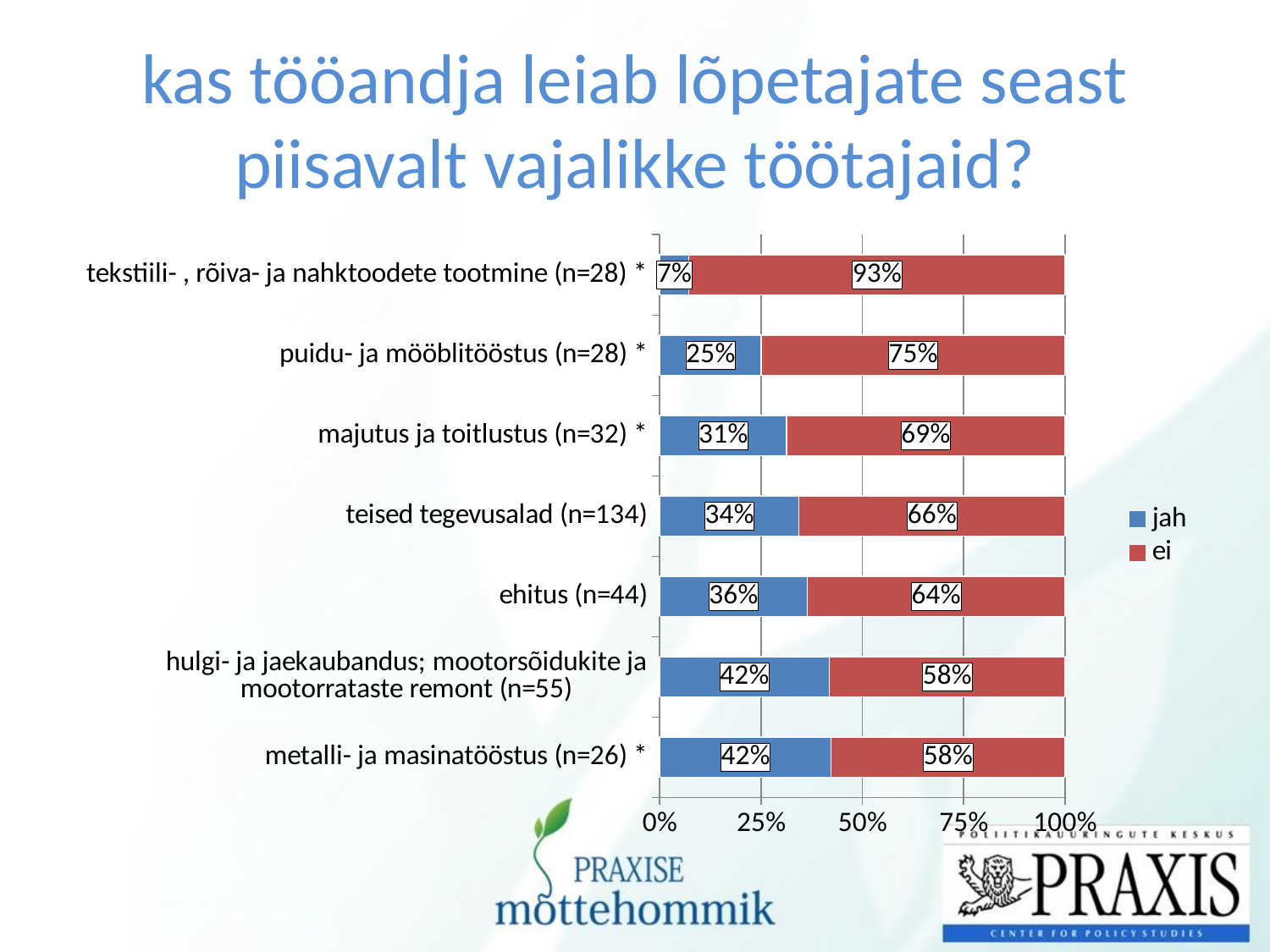
What is the total of the stacked bar for "metalli- ja masinatööstus (n=26) *"? 100% Which category has the highest "ei" value? tekstiili- , rõiva- ja nahktoodete tootmine (n=28) * What is the difference between the "ei" and "jah" values for "puidu- ja mööblitööstus (n=28) *"? 50% Which is larger: the "jah" value for "teised tegevusalad (n=134)" or the "jah" value for "puidu- ja mööblitööstus (n=28) *"? teised tegevusalad (n=134) What is the "jah" value for "ehitus (n=44)"? 36% How many categories are shown in the chart? 7 Which category has the lowest "jah" value? tekstiili- , rõiva- ja nahktoodete tootmine (n=28) * What is the "jah" value for "majutus ja toitlustus (n=32) *"? 31% Which colour represents the "ei" series in the chart? red What is the "ei" value for "tekstiili- , rõiva- ja nahktoodete tootmine (n=28) *"? 93% How many series does the legend list? 2 What kind of chart is shown on the slide? stacked bar chart